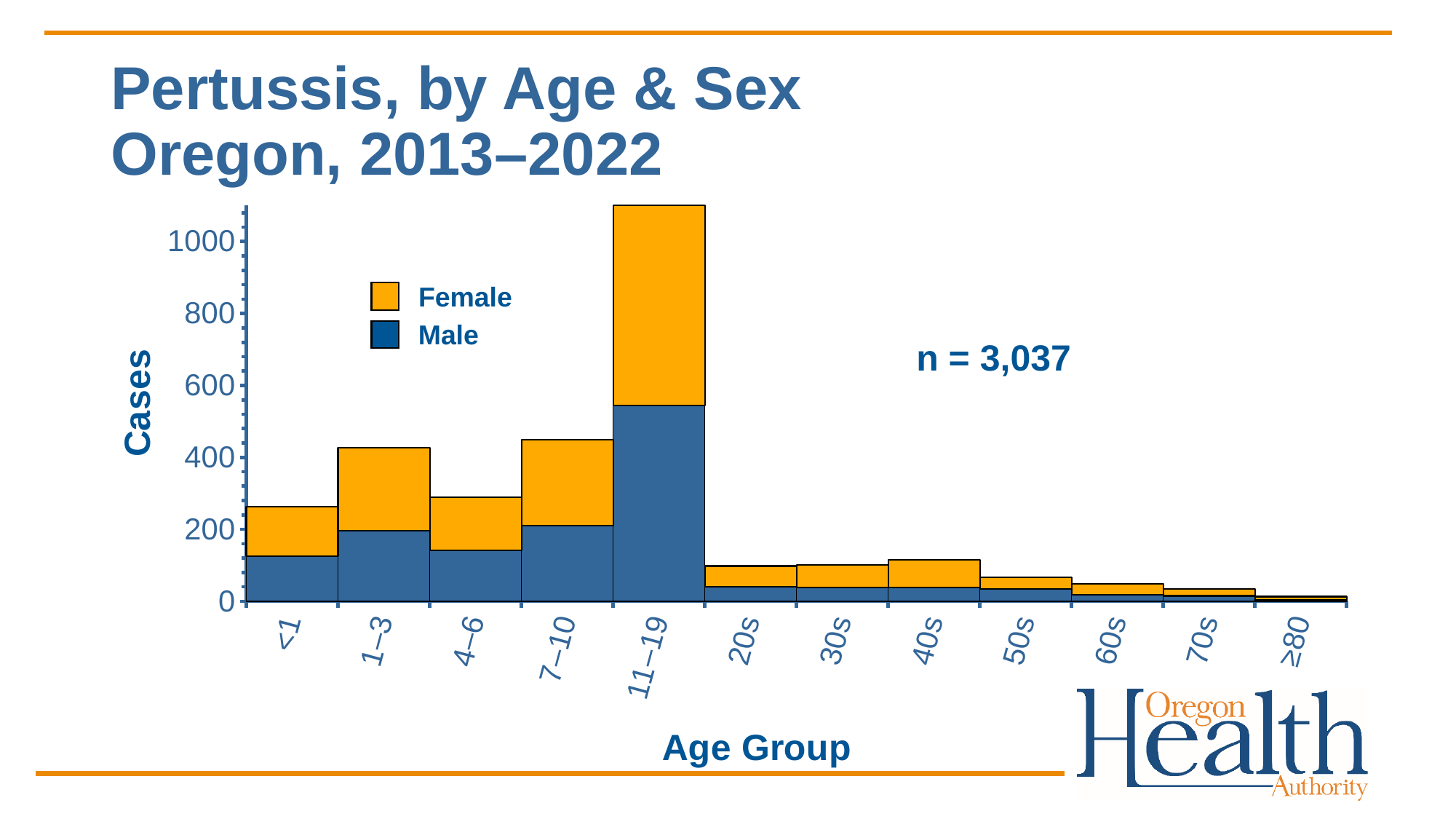
Is the total number of cases for the 20s age group greater or less than 200? less Is the total number of cases for the 4–6 age group greater or less than 400? less Is the total number of cases for the 11–19 age group greater or less than 1000? greater How many age groups are shown on the x axis? 12 What total sample size (n) is printed on the chart? n = 3,037 Which age group has more total cases, 7–10 or 4–6? 7–10 How many series does the legend list? 2 Which age group has the highest total number of cases? 11–19 Which age group has the lowest total number of cases? ≥80 What kind of chart is shown on the slide? Stacked bar chart